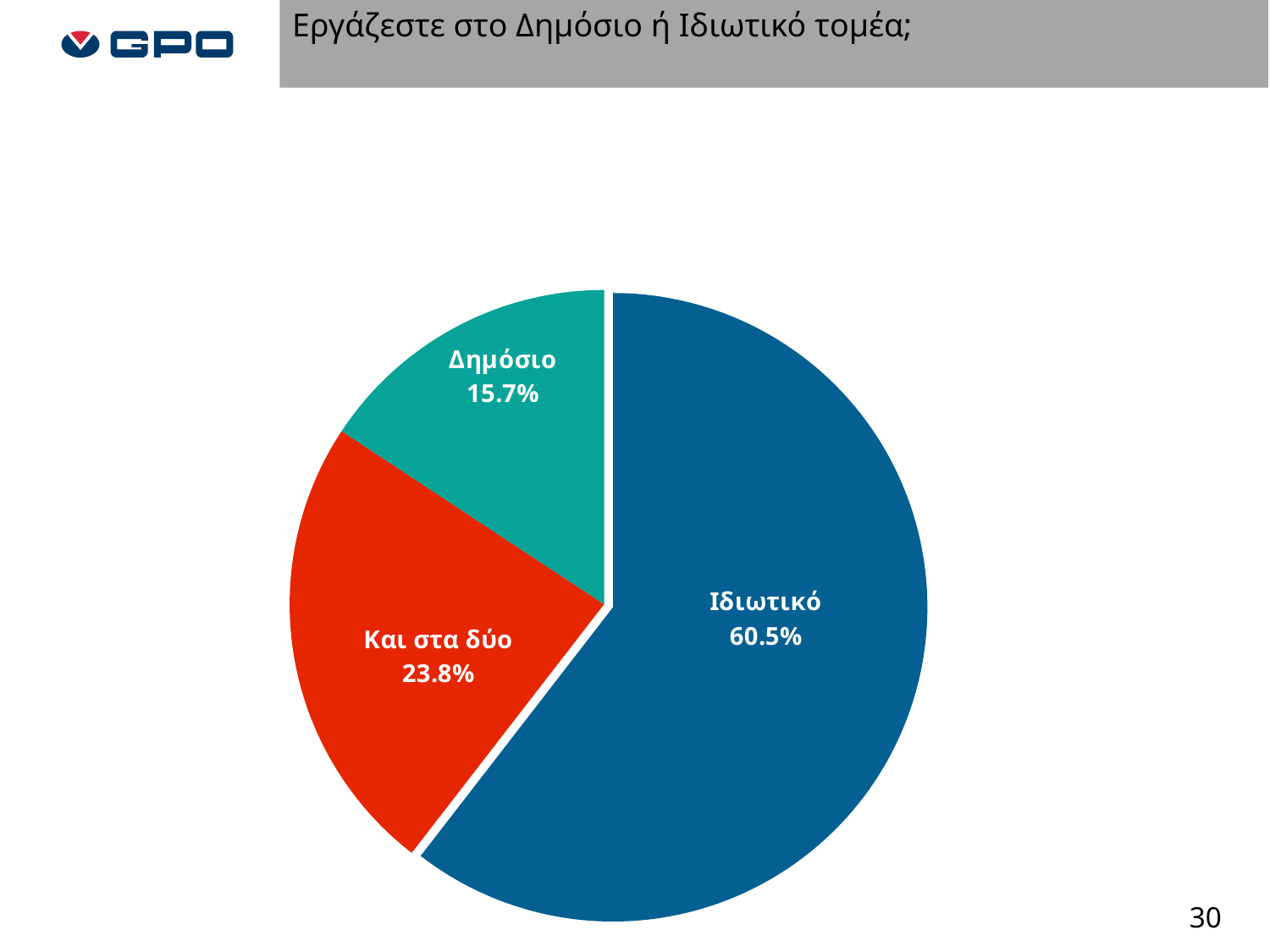
What is the difference between the values for Ιδιωτικό and Και στα δύο? 36.7% What is the value for Δημόσιο? 15.7% What colour is the slice for Και στα δύο? red What is the title of the slide containing the chart? Εργάζεστε στο Δημόσιο ή Ιδιωτικό τομέα; What is the value for Και στα δύο? 23.8% Which is larger, the value for Και στα δύο or the value for Δημόσιο? Και στα δύο How many categories does the pie chart show? 3 Which category has the smallest share of the pie? Δημόσιο What is the difference between the values for Και στα δύο and Δημόσιο? 8.1% What kind of chart is shown on the slide? pie chart Which category has the largest share of the pie? Ιδιωτικό What is the value for Ιδιωτικό? 60.5%